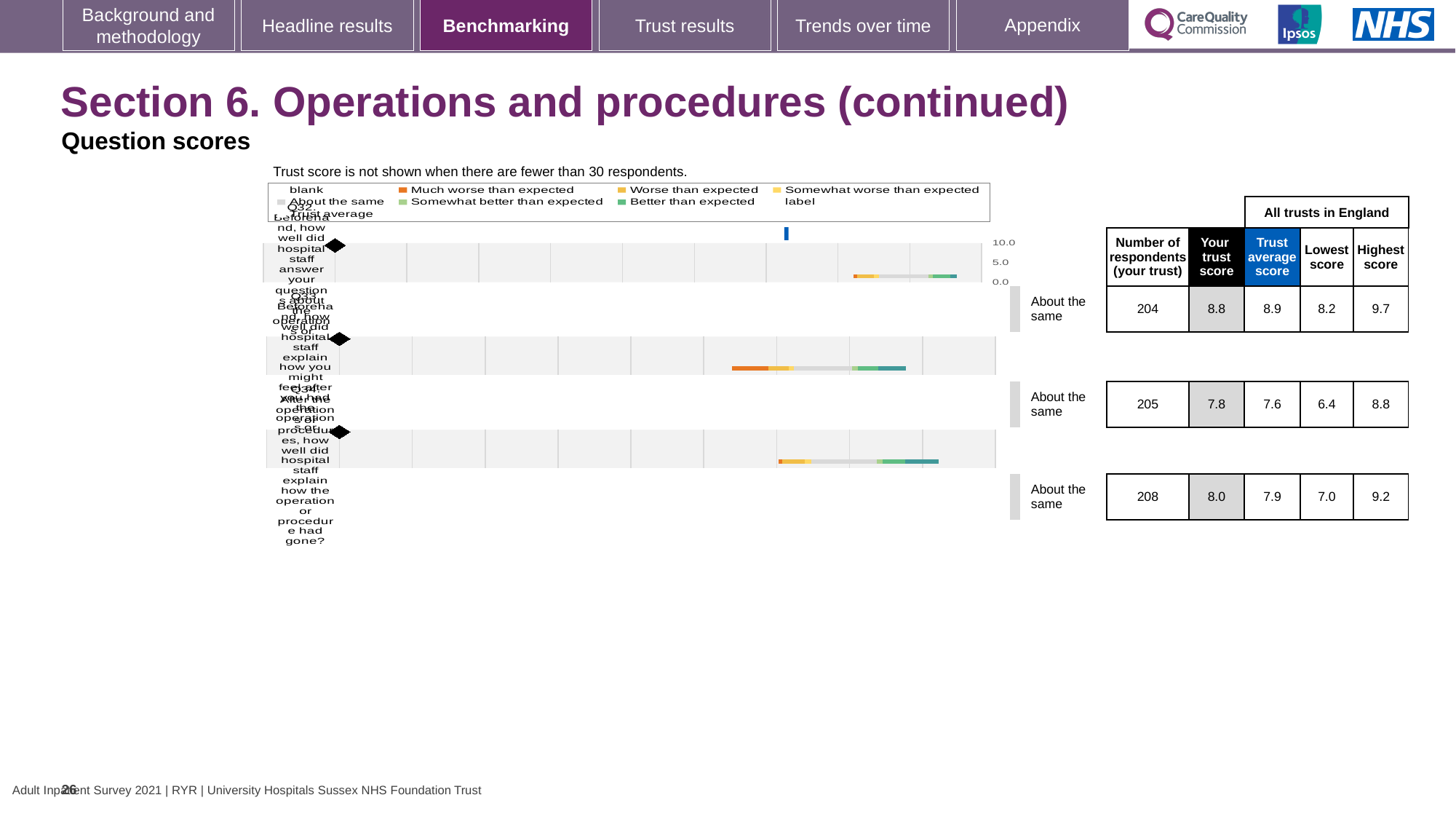
In the benchmarking table, what is the 'Trust average score' for the second question row? 7.6 For the second question row, which is larger: 'Your trust score' or the 'Trust average score'? Your trust score In the benchmarking table, what is the 'Highest score' for the third question row? 9.2 In the benchmarking table, what is 'Your trust score' for the first question row? 8.8 How many question rows are shown in the benchmarking chart on this slide? 3 What benchmark category label is shown next to each of the three question rows? About the same In the benchmarking table, how many respondents are shown for the first question row? 204 What kind of chart is used to show the benchmarking results on this slide? Bar chart Which question row has the highest 'Your trust score' in the benchmarking table? The first row (8.8) Which question row has the lowest 'Lowest score' in the benchmarking table? The second row (6.4) For the second question row, what is the difference between 'Your trust score' and the 'Trust average score'? 0.2 In the benchmarking table, what is the 'Lowest score' for the second question row? 6.4